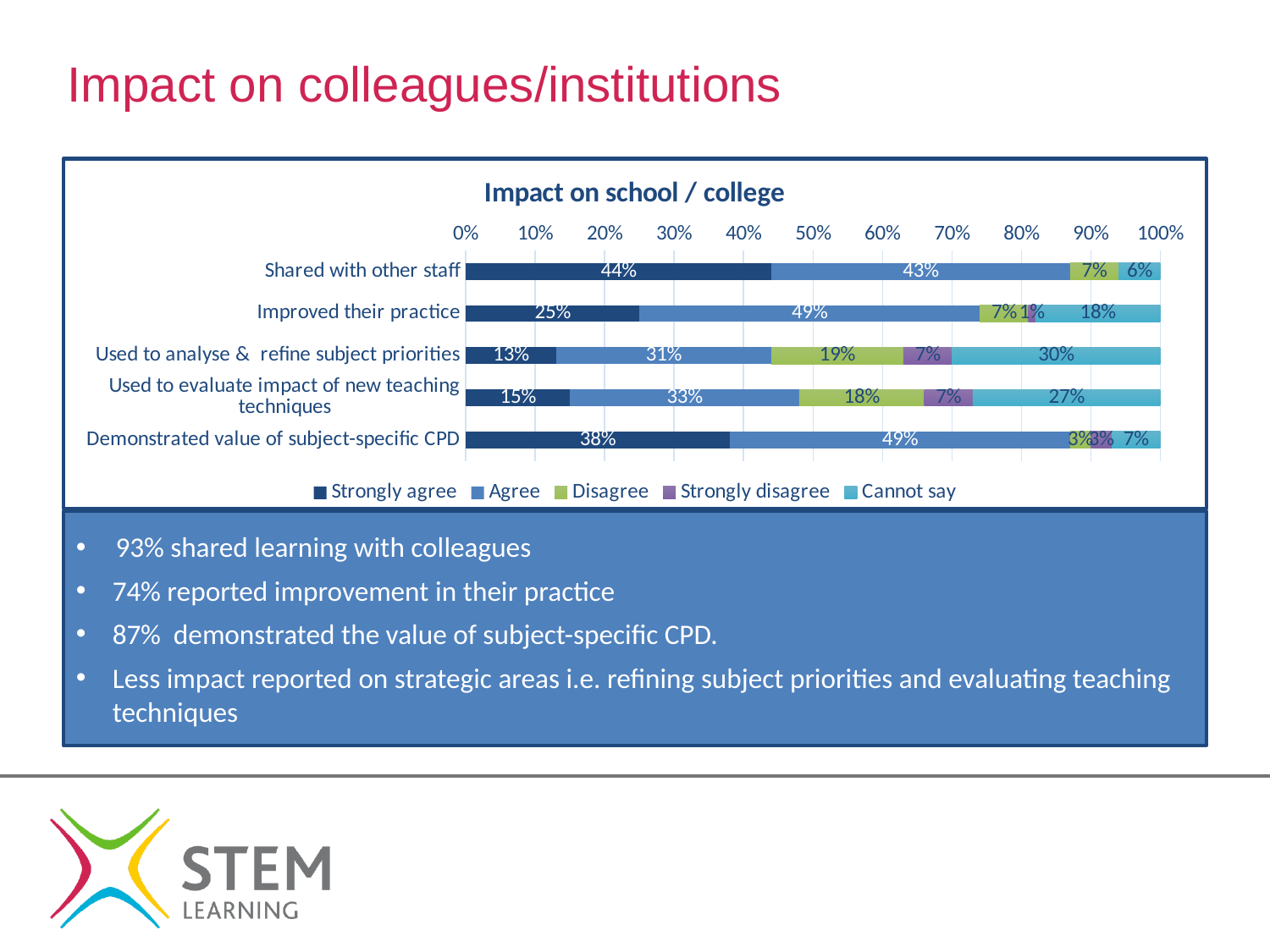
How many categories are shown in the 'Impact on school / college' chart? 5 How many series does the legend of the 'Impact on school / college' chart list? 5 In the 'Impact on school / college' chart, what percentage strongly agreed that they shared with other staff? 44% In the 'Impact on school / college' chart, which category has the lowest 'Strongly agree' value? Used to analyse & refine subject priorities In the 'Impact on school / college' chart, what is the 'Cannot say' value for 'Used to analyse & refine subject priorities'? 30% In the 'Impact on school / college' chart, what is the 'Disagree' value for 'Used to evaluate impact of new teaching techniques'? 18% In the 'Impact on school / college' chart, what is the 'Strongly agree' value for 'Demonstrated value of subject-specific CPD'? 38% What kind of chart is the 'Impact on school / college' chart? Stacked bar chart In the 'Impact on school / college' chart, what is the 'Agree' value for 'Improved their practice'? 49% In the 'Impact on school / college' chart, which has the larger 'Cannot say' value: 'Used to analyse & refine subject priorities' or 'Used to evaluate impact of new teaching techniques'? Used to analyse & refine subject priorities In the 'Impact on school / college' chart, which category has the highest 'Strongly agree' value? Shared with other staff In the 'Impact on school / college' chart, how many percentage points higher is the 'Agree' value for 'Improved their practice' than for 'Shared with other staff'? 6 percentage points